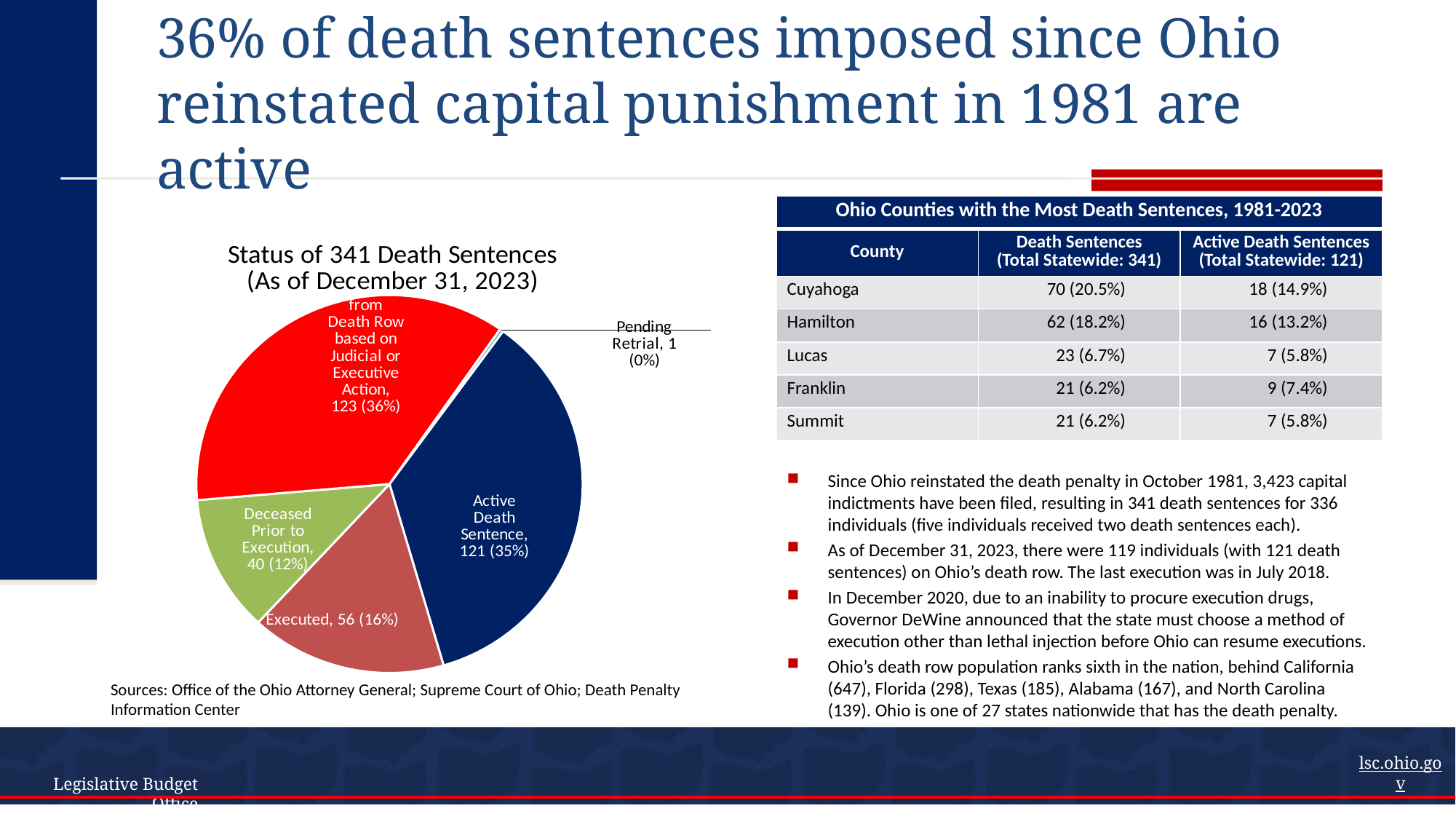
How many slices does the pie chart have? 5 Which is larger, the Executed slice or the Deceased Prior to Execution slice? Executed What value is shown for the Executed slice? 56 (16%) Which slice of the pie chart is the smallest? Pending Retrial What value is shown for the Pending Retrial slice? 1 (0%) What value is shown for the Deceased Prior to Execution slice? 40 (12%) What is the title of the pie chart? Status of 341 Death Sentences (As of December 31, 2023) What value is shown for the Active Death Sentence slice? 121 (35%) What kind of chart is shown on the slide? Pie chart What is the difference between the Active Death Sentence count and the Executed count? 65 What is the difference between the Executed count and the Deceased Prior to Execution count? 16 What share of the pie does the Executed slice represent? 16%